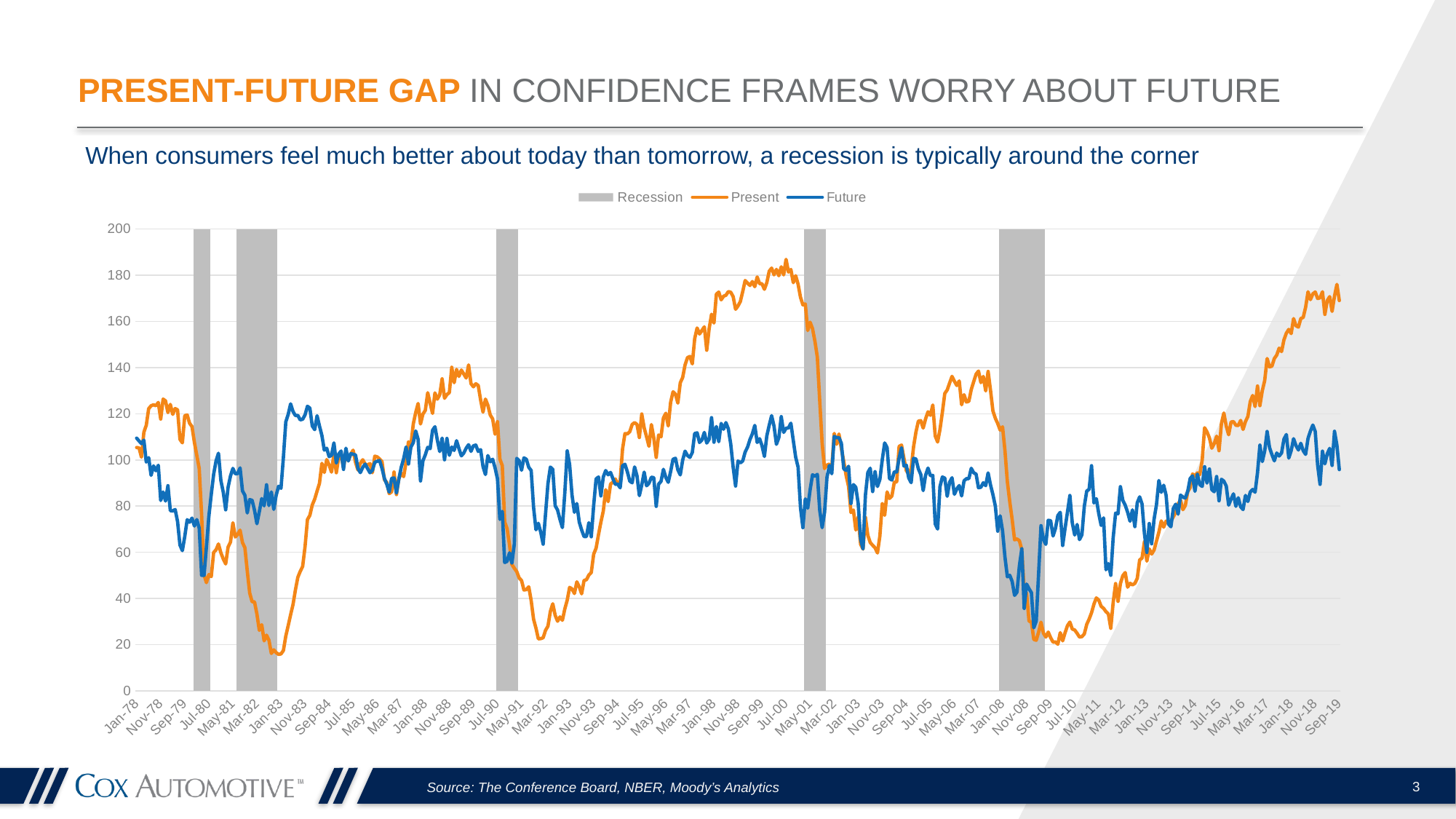
How many shaded recession bands are shown on the chart? 5 What kind of chart is shown on the slide? line chart At Jan-83, which series has the larger value, Present or Future? Future Which series reaches the highest value anywhere on the chart, Present or Future? Present Is the Present value around Sep-09 greater or less than 40? less Does the Present line rise or fall between Sep-09 and Sep-19? rise Is the Present value around Jul-00 greater or less than 160? greater Is the Future value around Sep-19 greater or less than 120? less How many entries does the chart legend list? 3 What colour is the Present line on the chart? orange At Sep-19, which series has the larger value, Present or Future? Present